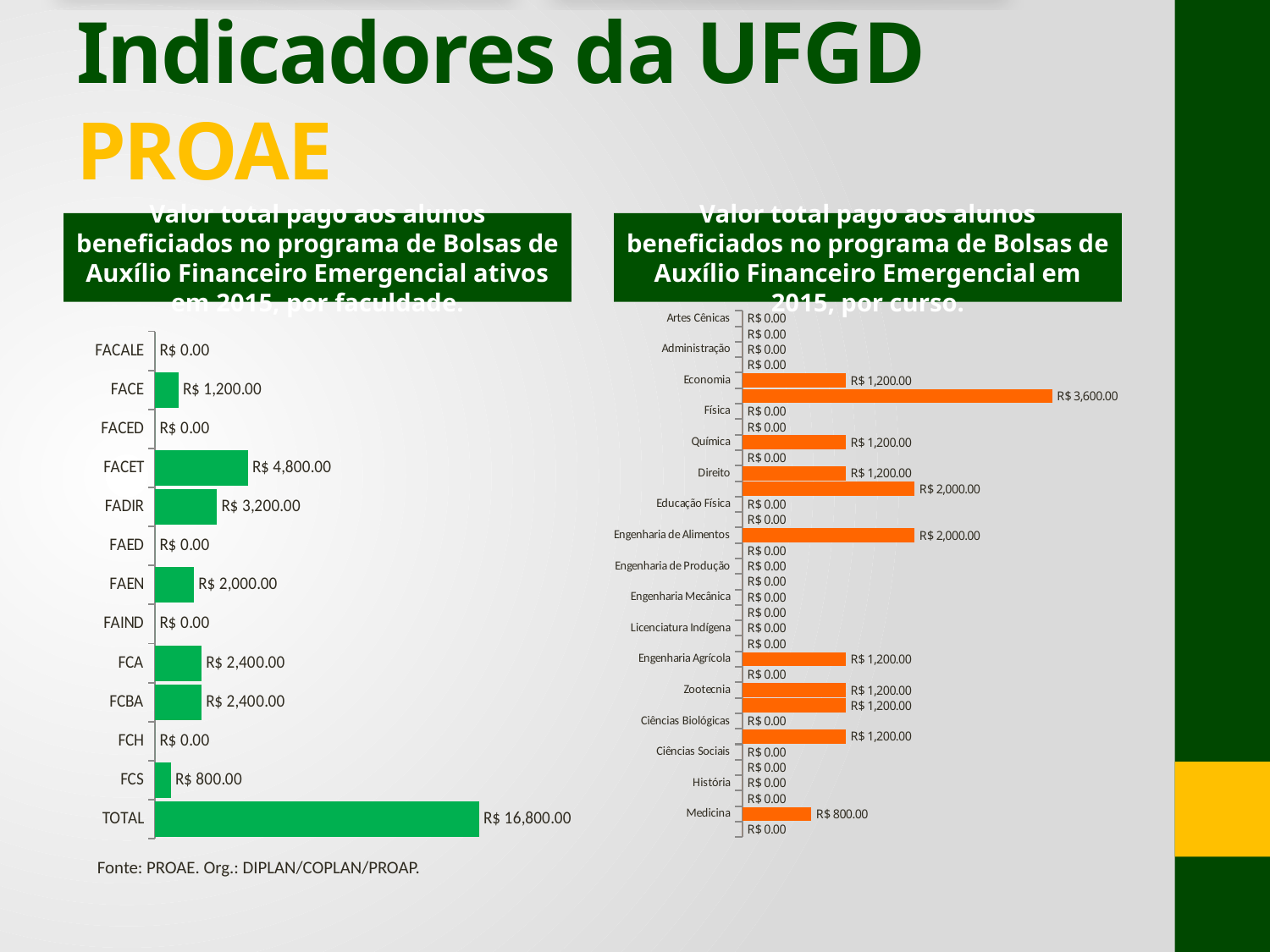
In the left chart (by faculdade), how many categories are shown, including TOTAL? 13 In the left chart (by faculdade), what is the value for FACET? R$ 4,800.00 What colour are the bars in the right chart (by curso)? Orange In the left chart (by faculdade), what is the difference between the values for FACET and FADIR? R$ 1,600.00 In the left chart (by faculdade), what is the value for FCS? R$ 800.00 In the left chart (by faculdade), which is larger, the value for FCA or the value for FCS? FCA In the right chart (by curso), what is the value labelled next to Medicina? R$ 800.00 What kind of chart is the left chart (by faculdade)? Bar chart In the left chart (by faculdade), how many faculdades have a value of R$ 0.00? 5 In the right chart (by curso), what is the largest value shown? R$ 3,600.00 In the left chart (by faculdade), what is the value for TOTAL? R$ 16,800.00 In the left chart (by faculdade), which faculdade (excluding TOTAL) has the highest value? FACET